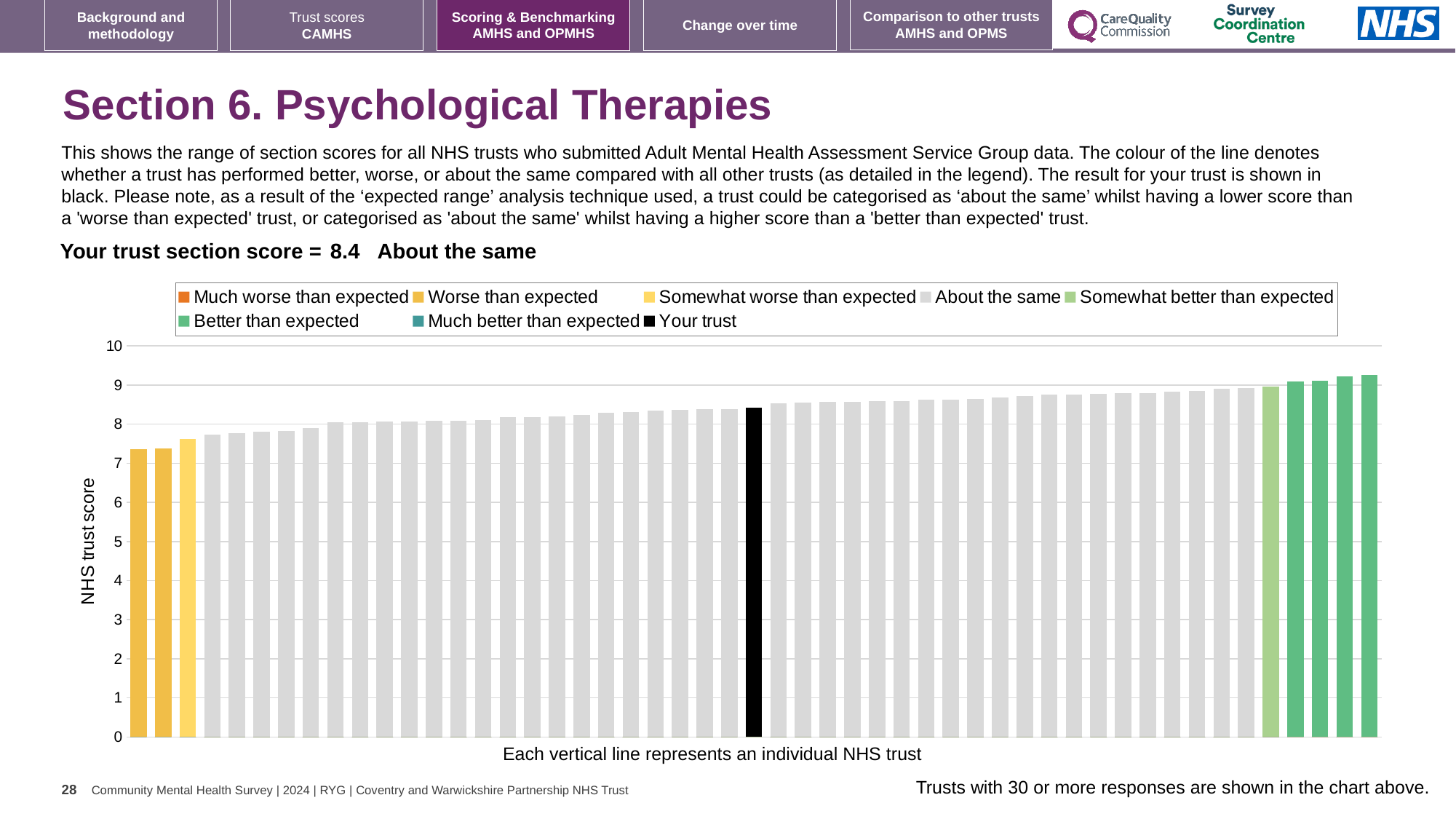
Is the value of the leftmost bar on the chart greater or less than 8? less Is the value of the black 'Your trust' bar greater or less than 8? greater What kind of chart is shown on the slide? bar chart Which is taller, the leftmost bar or the black 'Your trust' bar? the black 'Your trust' bar What is the section score for your trust shown on the slide? 8.4 How many bars on the chart are coloured as 'Better than expected' (dark green)? 4 Do the bar values rise or fall from left to right across the chart? rise Is the value of the tallest bar on the chart greater or less than 9? greater What is the label on the vertical axis of the chart? NHS trust score Which legend category does the shortest bar on the chart belong to? Worse than expected Which legend category does the tallest bar on the chart belong to? Better than expected How many entries does the chart legend list? 8